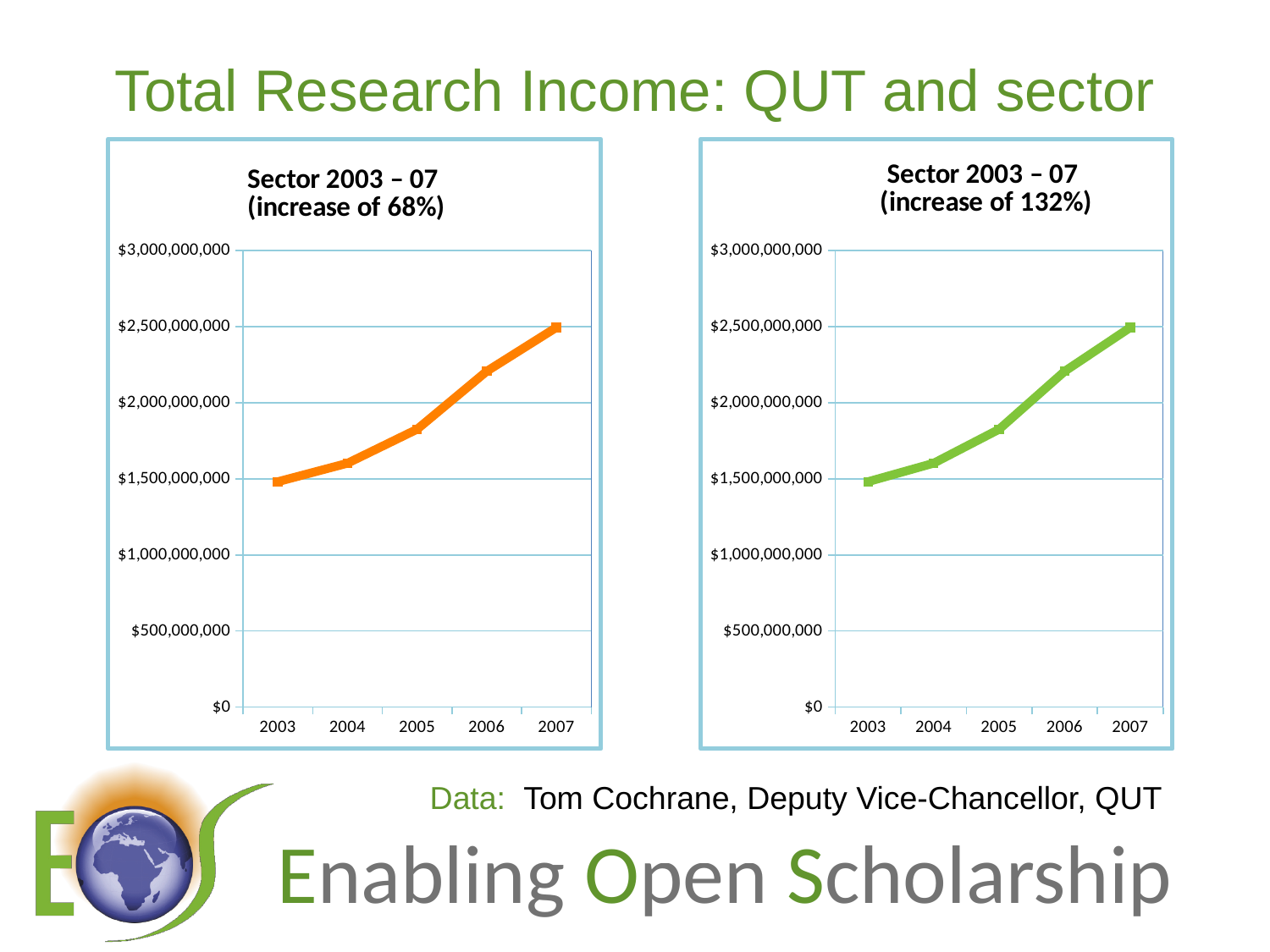
In the left chart, which is larger, the value for 2005 or the value for 2006? 2006 In the right chart, which year has the lowest value? 2003 What kind of chart is the left chart on the slide? line chart In the left chart, how many years are plotted along the x axis? 5 In the right chart, do the values rise or fall from 2003 to 2007? rise What kind of chart is the right chart on the slide? line chart In the right chart, is the value for 2006 greater or less than $2,000,000,000? greater What percentage increase is stated in the title of the right chart? 132% In the left chart, which year has the highest value? 2007 In the left chart, do the values rise or fall from 2003 to 2007? rise In the right chart, how many data points are plotted? 5